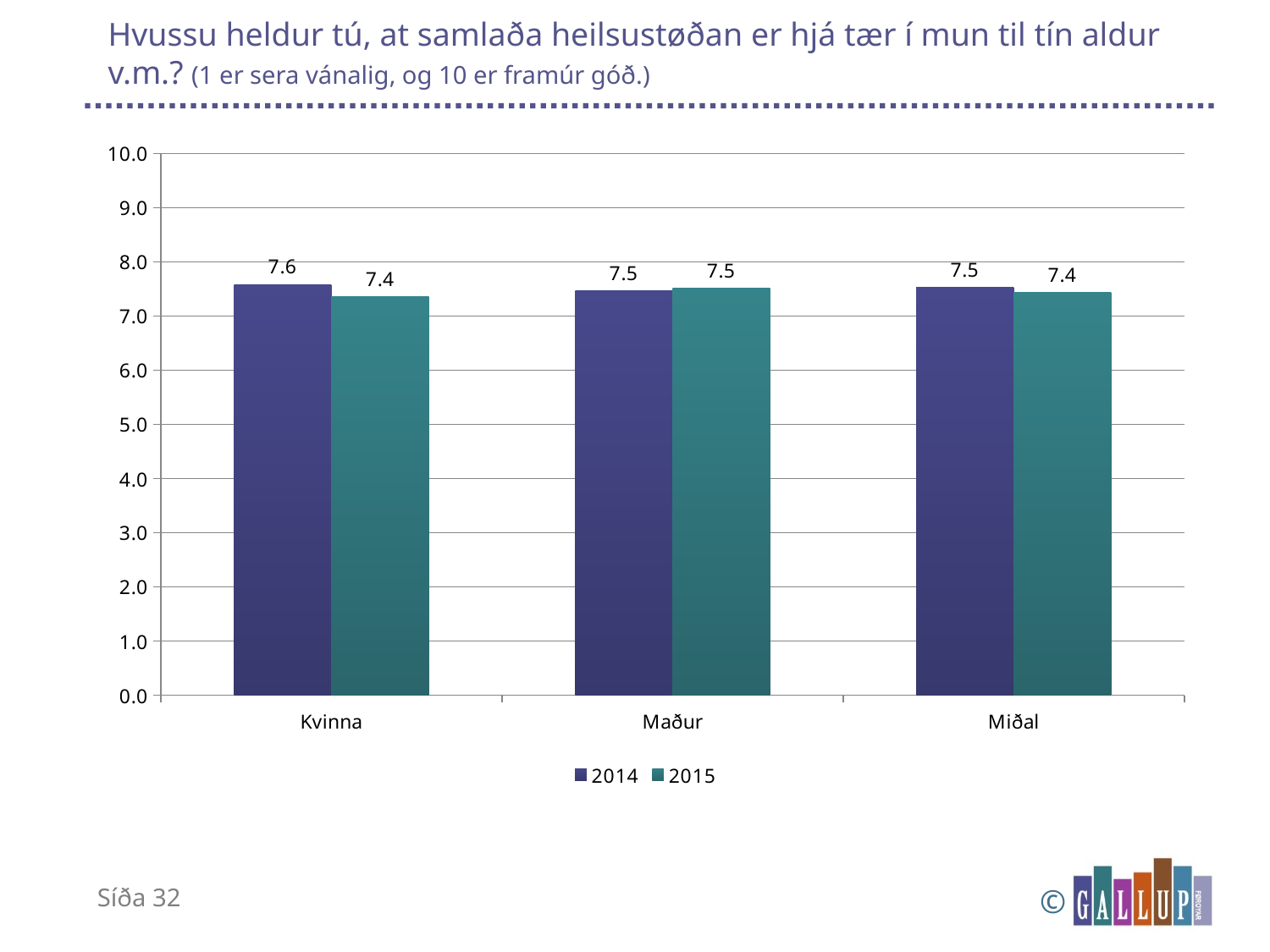
How many series does the legend list? 2 What is the value for Maður in the 2015 series? 7.5 For Kvinna, which is larger: the 2014 value or the 2015 value? 2014 What is the difference between the 2014 and 2015 values for Kvinna? 0.2 Is the 2015 value for Miðal greater or less than 8.0? less What kind of chart is shown on the slide? bar chart What is the value for Kvinna in the 2014 series? 7.6 What is the value for Miðal in the 2014 series? 7.5 Which category has the highest value in the 2014 series? Kvinna What is the value for Kvinna in the 2015 series? 7.4 How many categories are shown on the x axis? 3 Which series is shown in the teal colour in the legend? 2015